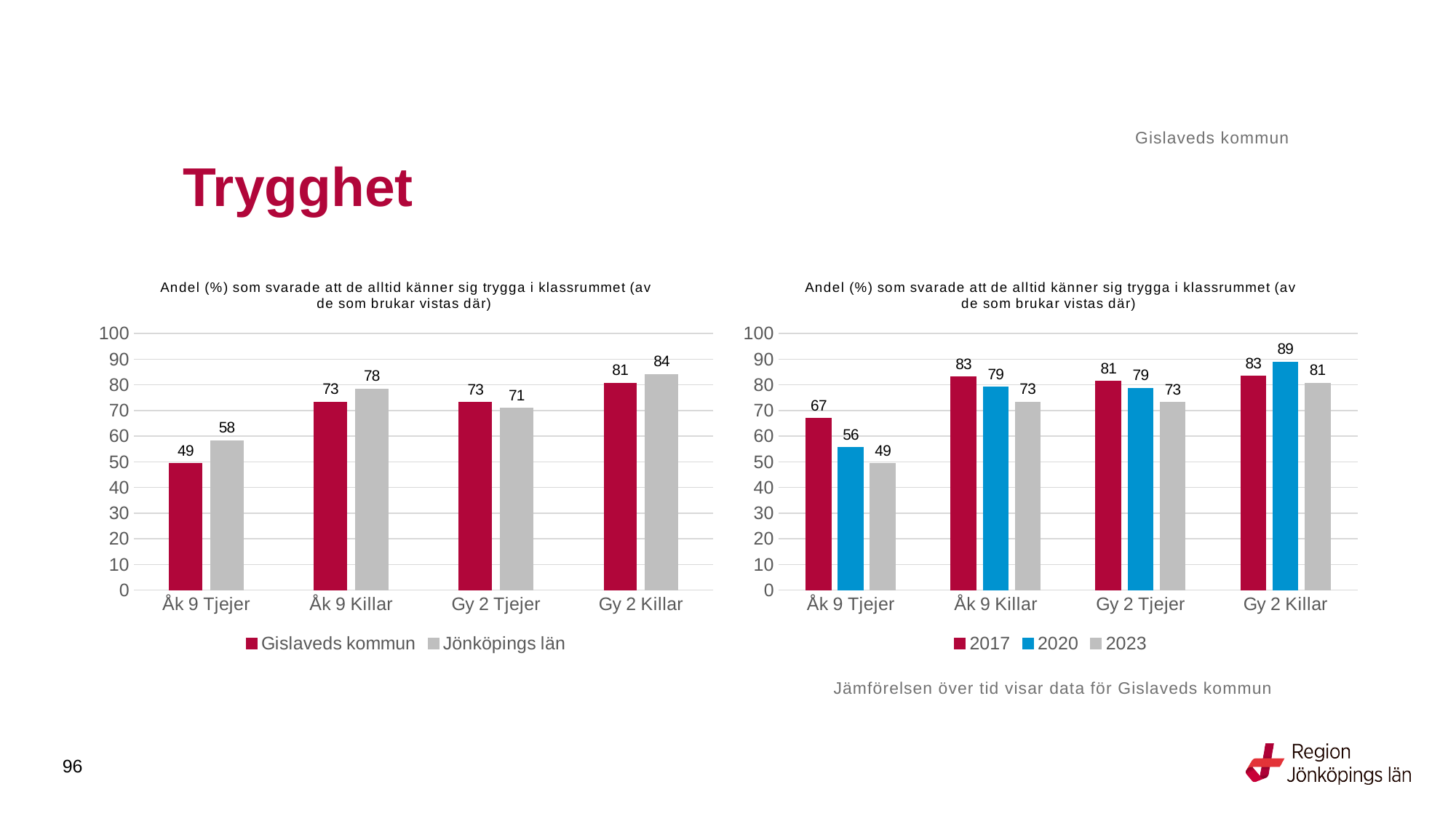
In the right chart, what is the difference between 2017 and 2023 for Åk 9 Tjejer? 18 How many categories are shown on the x axis of the right chart? 4 In the left chart, what is the value for Gislaveds kommun for Åk 9 Tjejer? 49 In the right chart, what is the value for 2020 for Åk 9 Tjejer? 56 In the right chart, which category has the highest value for 2020? Gy 2 Killar In the left chart, what is the value for Jönköpings län for Gy 2 Killar? 84 In the right chart, how many series does the legend list? 3 In the left chart, which is larger for Gy 2 Tjejer: Gislaveds kommun or Jönköpings län? Gislaveds kommun In the left chart, what is the difference between Jönköpings län and Gislaveds kommun for Åk 9 Tjejer? 9 In the left chart, which category has the lowest value for Gislaveds kommun? Åk 9 Tjejer How many series does the legend of the left chart list? 2 What kind of chart is the right chart? Bar chart